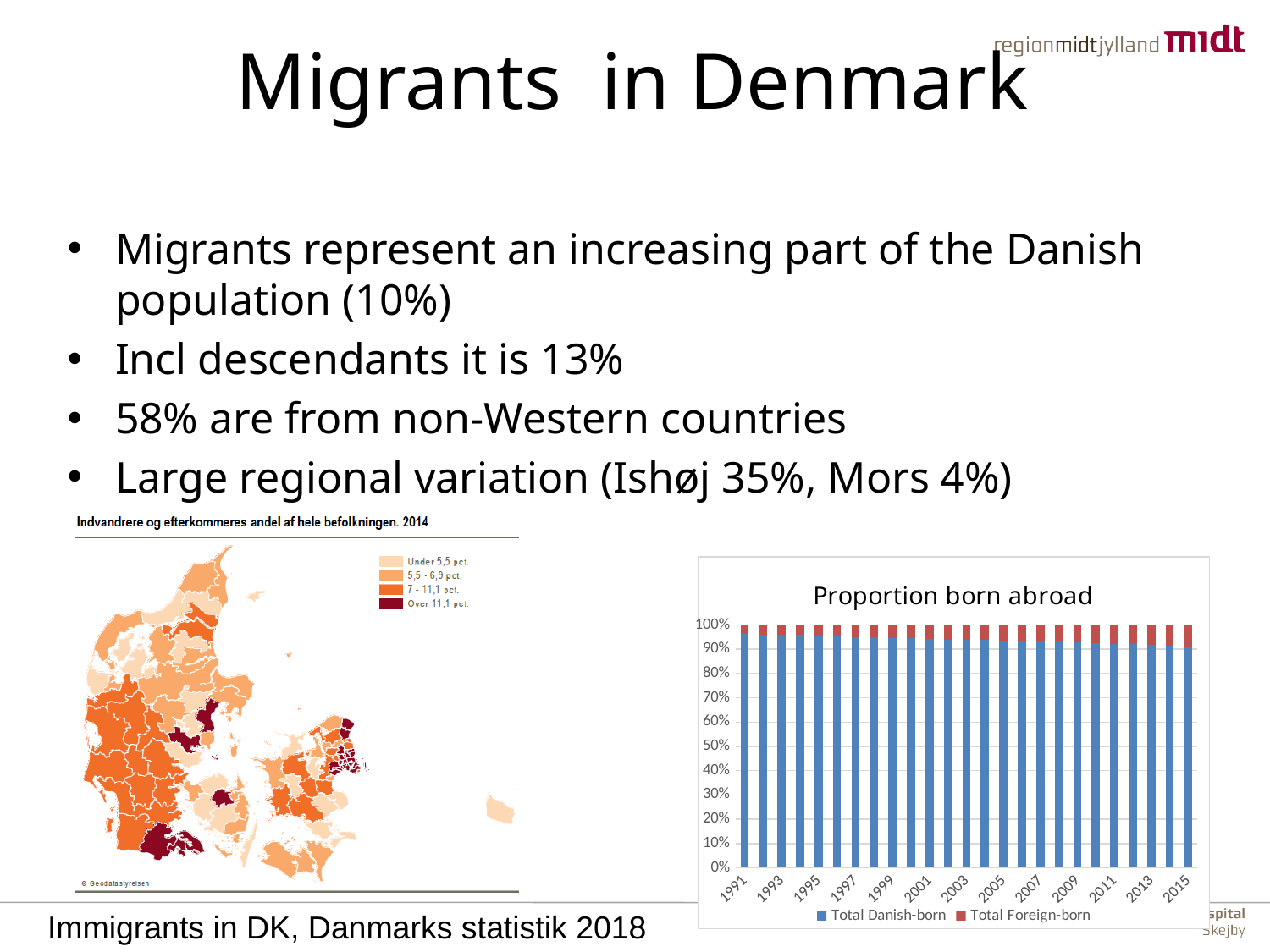
How many bars (years) are plotted in the 'Proportion born abroad' chart? 25 In the 'Proportion born abroad' chart, is the Total Danish-born value for 1991 greater or less than 90%? greater In the 'Proportion born abroad' chart, which colour represents Total Foreign-born? red In the 'Proportion born abroad' chart, which series is larger in 2015, Total Danish-born or Total Foreign-born? Total Danish-born In the 'Proportion born abroad' chart, what is the last year shown on the x axis? 2015 In the 'Proportion born abroad' chart, is the Total Foreign-born value for 2015 greater or less than 20%? less How many series does the legend of the 'Proportion born abroad' chart list? 2 What kind of chart is the 'Proportion born abroad' chart? stacked bar chart What are the two series named in the legend of the 'Proportion born abroad' chart? Total Danish-born and Total Foreign-born In the 'Proportion born abroad' chart, does the Total Foreign-born share rise or fall from 1991 to 2015? rise In the 'Proportion born abroad' chart, does the Total Danish-born share rise or fall from 1991 to 2015? fall In the 'Proportion born abroad' chart, what is the first year shown on the x axis? 1991